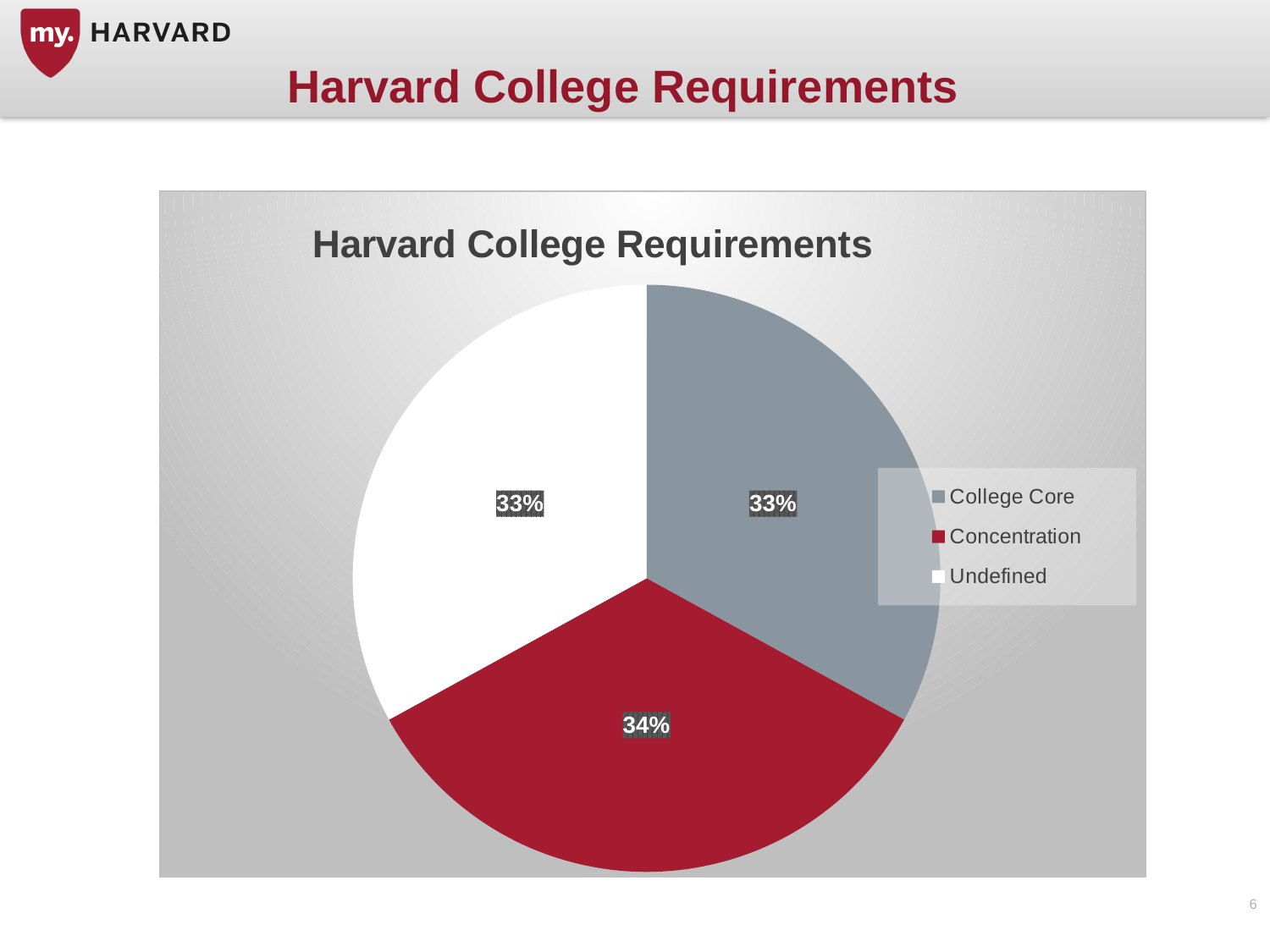
What share of the pie is Undefined? 33% How many entries does the legend list? 3 What share of the pie is Concentration? 34% What is the title of the chart? Harvard College Requirements Which slice is the largest? Concentration Is the share for Concentration greater or less than 30%? greater What is the difference between the Concentration share and the College Core share? 1% What share of the pie is College Core? 33% How many slices does the pie chart have? 3 Which colour represents Concentration in the chart? red What kind of chart is shown on the slide? pie chart